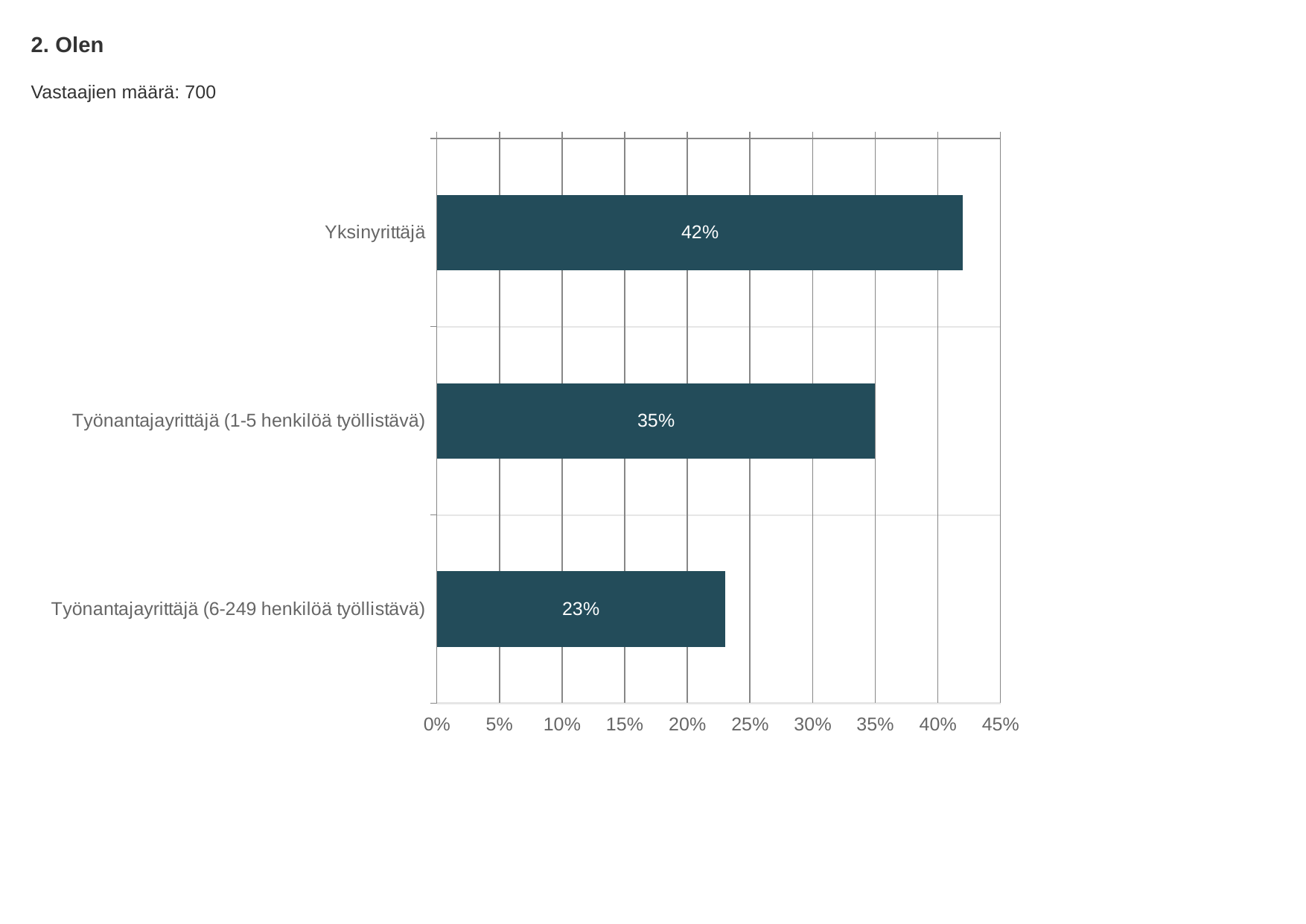
What is the number of respondents (Vastaajien määrä) stated on the slide? 700 What is the value for Työnantajayrittäjä (6-249 henkilöä työllistävä)? 23% Which category has the highest value? Yksinyrittäjä What is the difference between the values for Yksinyrittäjä and Työnantajayrittäjä (6-249 henkilöä työllistävä)? 19% Which category has the lowest value? Työnantajayrittäjä (6-249 henkilöä työllistävä) Is the value for Yksinyrittäjä greater or less than 40%? greater What is the value for Yksinyrittäjä? 42% What is the value for Työnantajayrittäjä (1-5 henkilöä työllistävä)? 35% What is the difference between the values for Yksinyrittäjä and Työnantajayrittäjä (1-5 henkilöä työllistävä)? 7% Which is larger: the value for Työnantajayrittäjä (1-5 henkilöä työllistävä) or Työnantajayrittäjä (6-249 henkilöä työllistävä)? Työnantajayrittäjä (1-5 henkilöä työllistävä) How many categories are shown in the chart? 3 What kind of chart is shown on the slide? bar chart